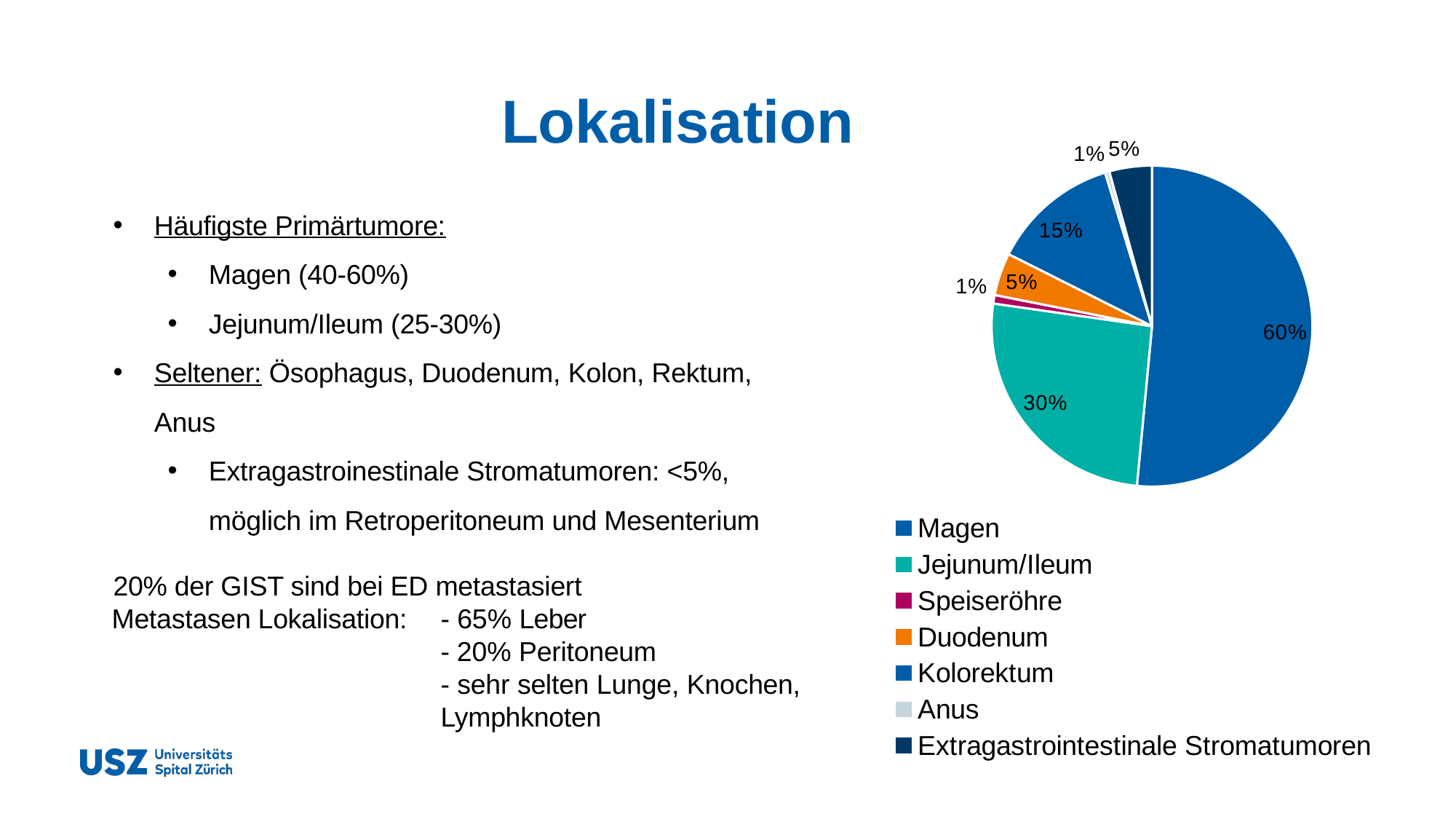
What type of chart is shown on the slide? pie chart What percentage is shown for Duodenum in the pie chart? 5% Which legend entry of the pie chart is shown in orange? Duodenum What percentage is shown for Speiseröhre in the pie chart? 1% What is the difference between the Magen and Jejunum/Ileum percentages in the pie chart? 30% Which category has the largest slice in the pie chart? Magen What percentage is shown for Kolorektum in the pie chart? 15% Which is larger in the pie chart, Kolorektum or Duodenum? Kolorektum What percentage is shown for Jejunum/Ileum in the pie chart? 30% How many categories does the legend of the pie chart list? 7 What is the difference between the Kolorektum and Duodenum percentages in the pie chart? 10% What percentage is shown for Magen in the pie chart? 60%